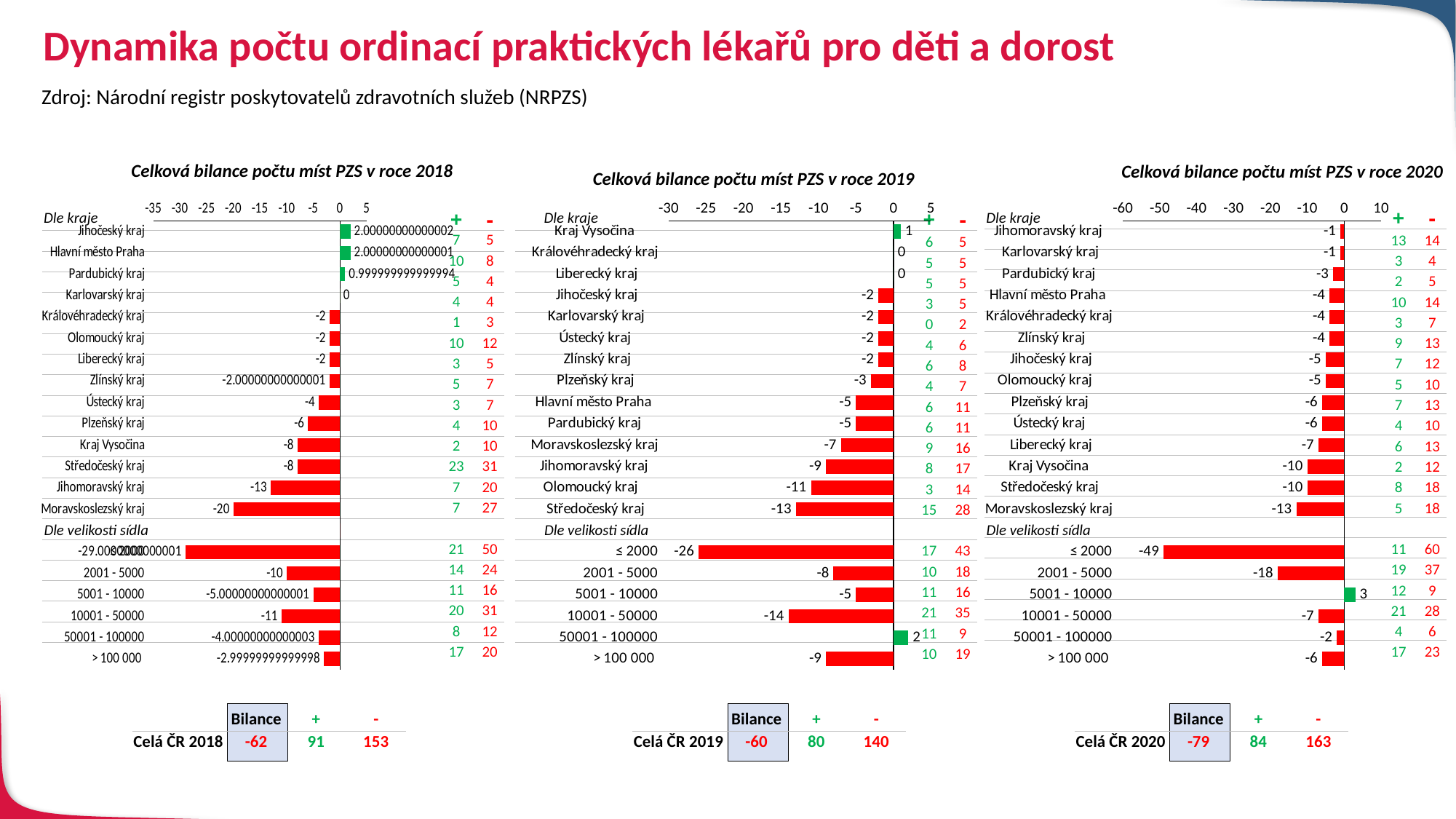
In the chart 'Celková bilance počtu míst PZS v roce 2018', what is the value for Moravskoslezský kraj? -20 What type of chart is 'Celková bilance počtu míst PZS v roce 2020'? bar chart How many regions (Dle kraje) are plotted in the chart 'Celková bilance počtu míst PZS v roce 2019'? 14 In the chart 'Celková bilance počtu míst PZS v roce 2020', which region (Dle kraje) has the lowest value? Moravskoslezský kraj In the chart 'Celková bilance počtu míst PZS v roce 2020', what is the difference between the values for ≤ 2000 and 2001 - 5000? 31 In the chart 'Celková bilance počtu míst PZS v roce 2018', what is the value for Jihomoravský kraj? -13 In the chart 'Celková bilance počtu míst PZS v roce 2019', what is the value for Středočeský kraj? -13 In the chart 'Celková bilance počtu míst PZS v roce 2020', what is the value for the size category 5001 - 10000? 3 In the chart 'Celková bilance počtu míst PZS v roce 2020', what is the value for the size category ≤ 2000? -49 In the chart 'Celková bilance počtu míst PZS v roce 2019', which is larger, the value for Olomoucký kraj or the value for Jihomoravský kraj? Jihomoravský kraj In the chart 'Celková bilance počtu míst PZS v roce 2019', what is the value for the size category ≤ 2000? -26 In the chart 'Celková bilance počtu míst PZS v roce 2019', which region (Dle kraje) has the highest value? Kraj Vysočina